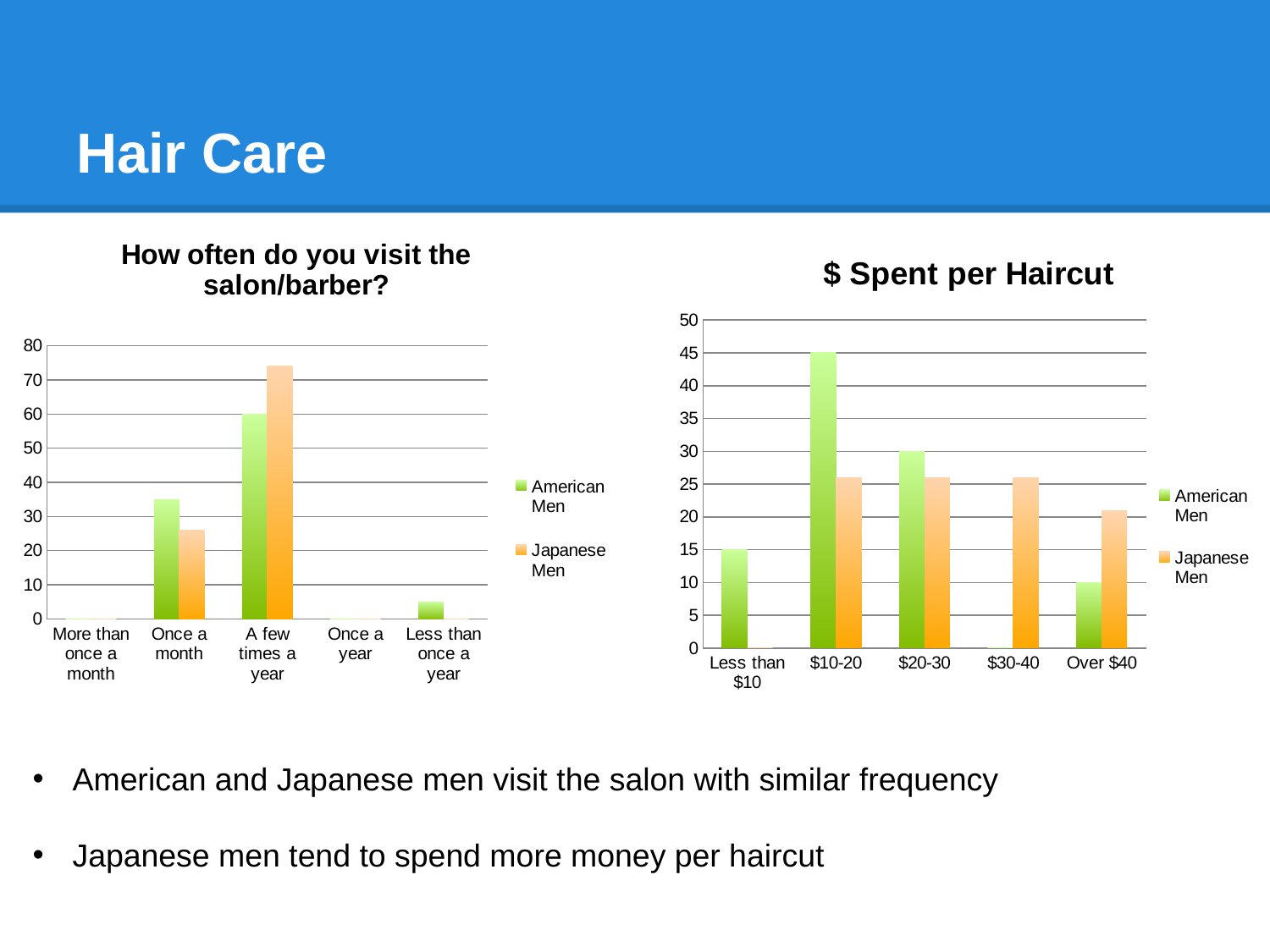
How many series does the legend of the 'How often do you visit the salon/barber?' chart list? 2 In the '$ Spent per Haircut' chart, what is the difference between the American Men values for $10-20 and $20-30? 15 In the 'How often do you visit the salon/barber?' chart, which category has the highest value for Japanese Men? A few times a year How many categories are shown on the x axis of the '$ Spent per Haircut' chart? 5 In the '$ Spent per Haircut' chart, which category has the highest value for American Men? $10-20 In the '$ Spent per Haircut' chart, what is the value for American Men in the 'Less than $10' category? 15 In the '$ Spent per Haircut' chart, what is the value for American Men in the $10-20 category? 45 In the 'How often do you visit the salon/barber?' chart, for 'Once a month', which series has the larger value, American Men or Japanese Men? American Men In the '$ Spent per Haircut' chart, what is the value for American Men in the $20-30 category? 30 In the 'How often do you visit the salon/barber?' chart, what is the value for American Men for 'A few times a year'? 60 In the '$ Spent per Haircut' chart, is the value for Japanese Men in the $30-40 category greater or less than 30? less In the 'How often do you visit the salon/barber?' chart, is the value for Japanese Men for 'A few times a year' greater or less than 70? greater